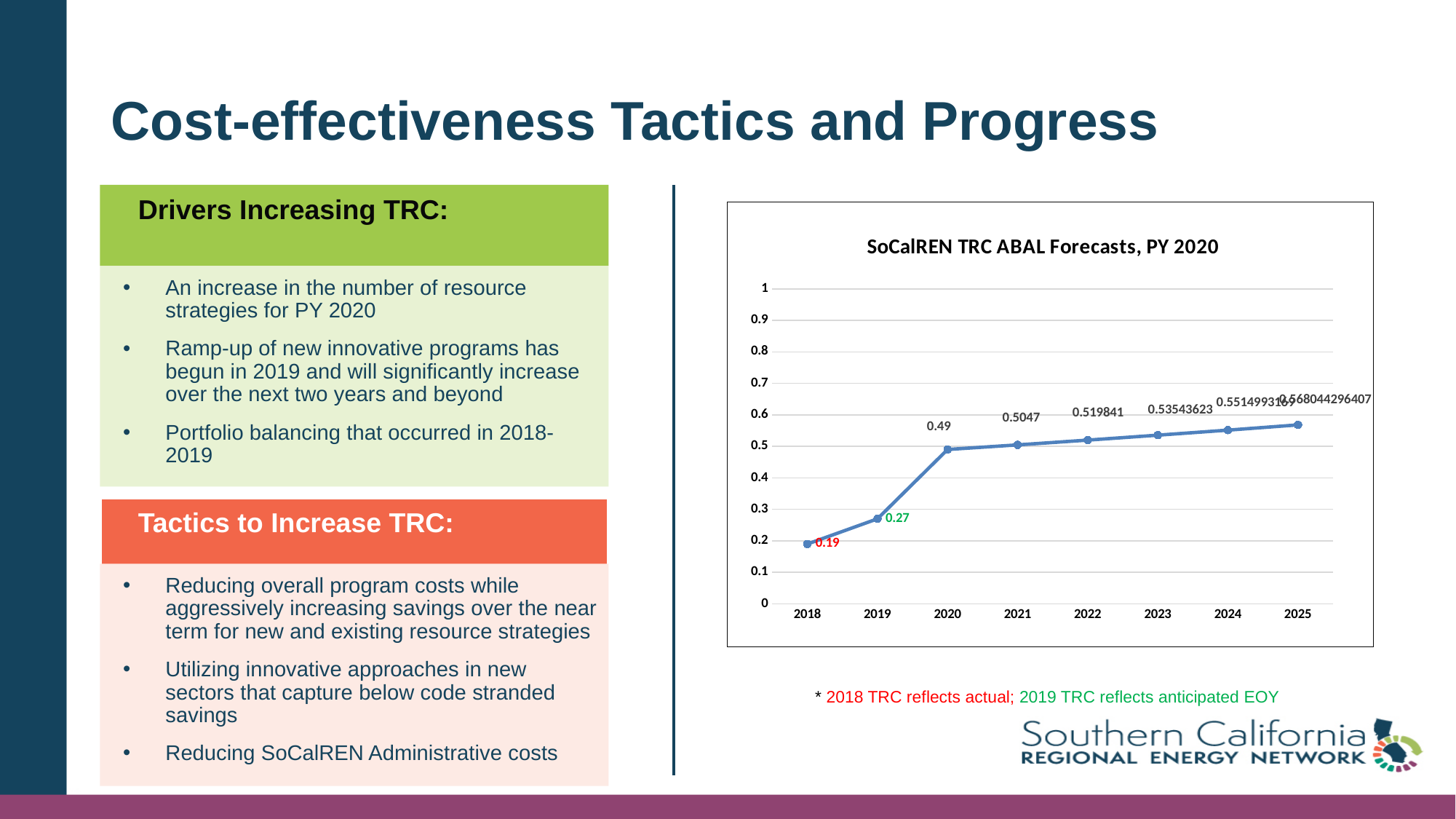
What is the TRC value for 2019? 0.27 Is the TRC value for 2025 greater or less than 0.6? less What kind of chart is shown? line chart What is the TRC value for 2021? 0.5047 What is the difference between the TRC values for 2020 and 2019? 0.22 What is the TRC value for 2023? 0.53543623 Do the TRC values rise or fall from 2018 to 2025? rise Which year has the lowest TRC value? 2018 How many years are plotted on the chart? 8 Which year has the highest TRC value? 2025 What is the TRC value for 2018? 0.19 What is the TRC value for 2020? 0.49